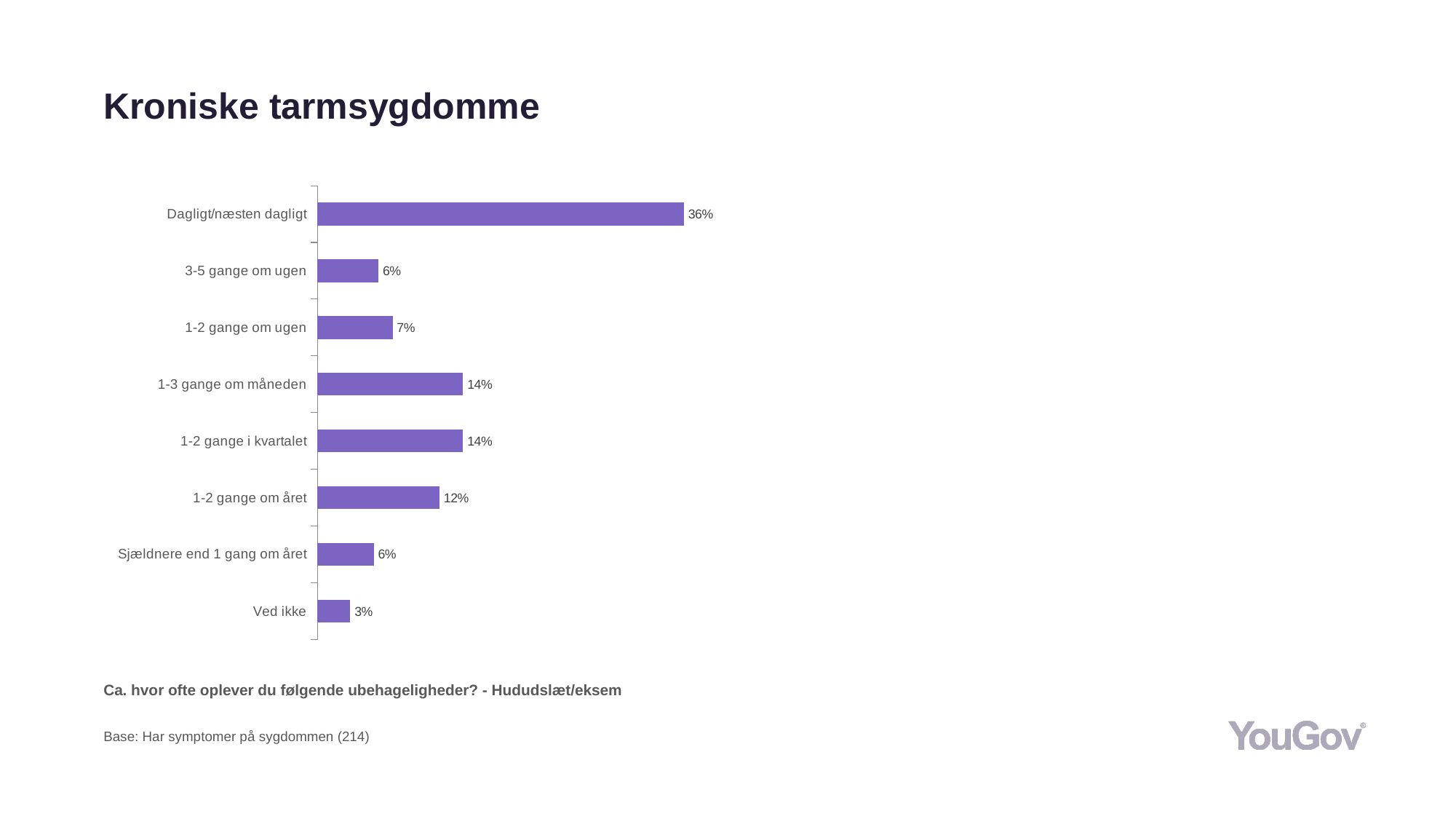
What is the difference between "Dagligt/næsten dagligt" and "1-3 gange om måneden"? 22% Which category has the lowest value? Ved ikke What is the value for "Ved ikke"? 3% What is the value for "Dagligt/næsten dagligt"? 36% What kind of chart is shown on the slide? Bar chart How many categories are shown in the chart? 8 What is the value for "1-2 gange om året"? 12% Which is larger, "1-2 gange om året" or "1-2 gange om ugen"? 1-2 gange om året What is the value for "1-2 gange om ugen"? 7% What is the title of the slide? Kroniske tarmsygdomme What is the difference between "1-2 gange om året" and "Sjældnere end 1 gang om året"? 6% Which category has the highest value? Dagligt/næsten dagligt